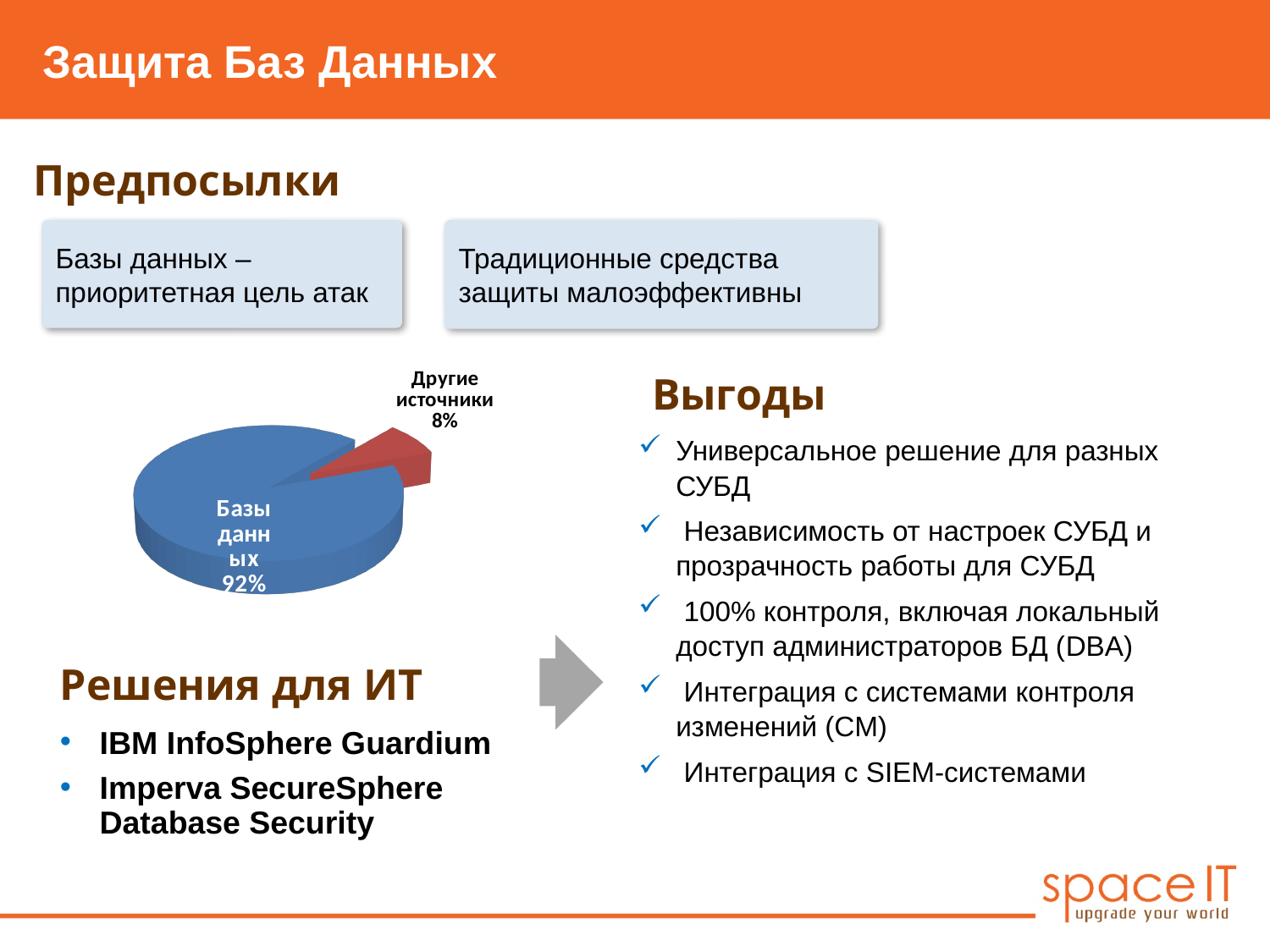
What kind of chart is shown on the slide? pie chart What share of the pie does the 'Другие источники' slice represent? 8% Which is larger, the 'Базы данных' slice or the 'Другие источники' slice? Базы данных What share of the pie does the 'Базы данных' slice represent? 92% Which slice of the pie is the smallest? Другие источники What colour is the 'Другие источники' slice of the pie? red Which slice of the pie is the largest? Базы данных What colour is the 'Базы данных' slice of the pie? blue What is the difference in percentage points between the 'Базы данных' slice and the 'Другие источники' slice? 84 How many slices does the pie chart have? 2